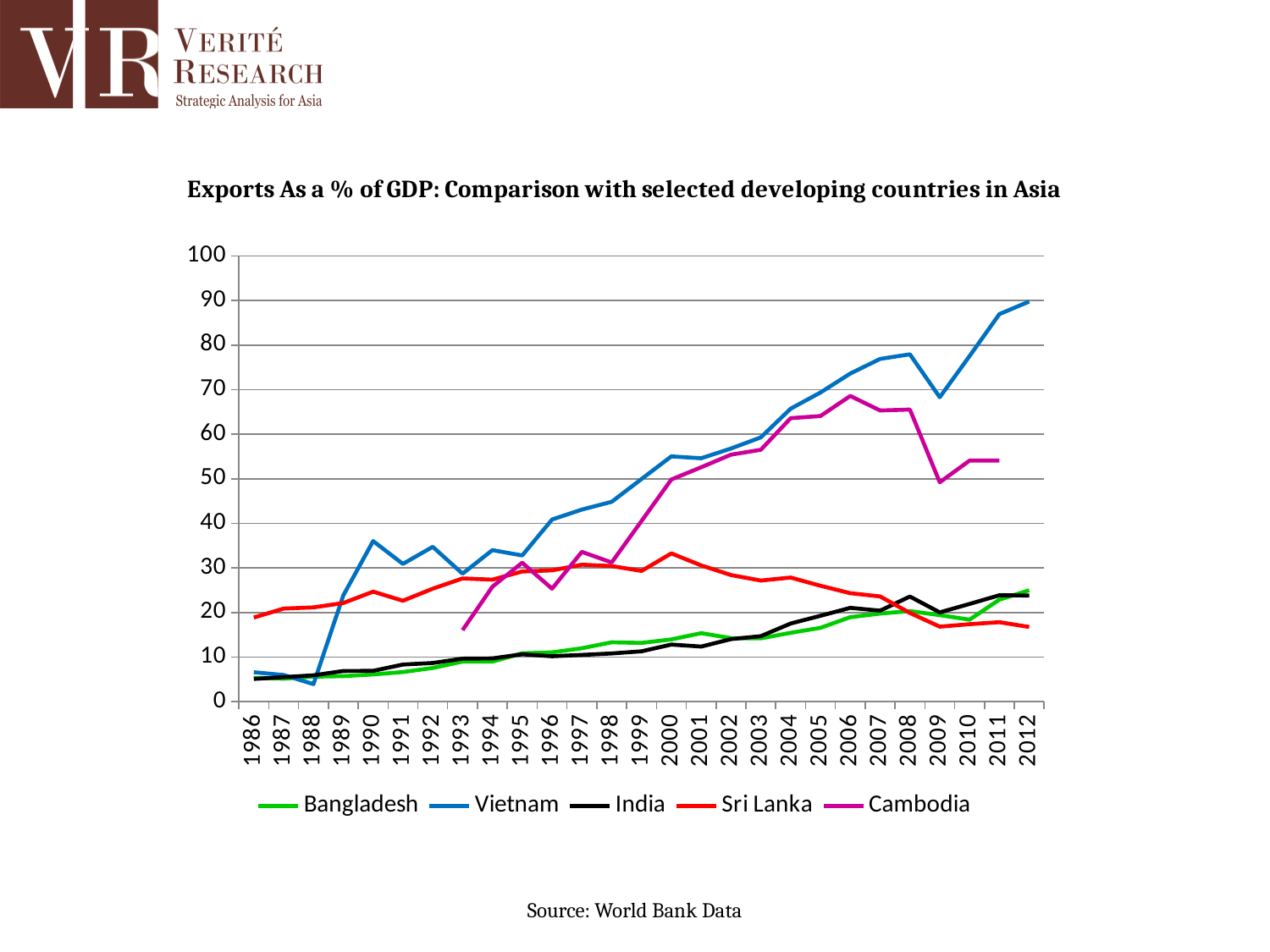
In 1986, which is larger: the value for Sri Lanka or the value for India? Sri Lanka Which country has the highest exports as a % of GDP in 2012? Vietnam Does the Sri Lanka line generally rise or fall from 2000 to 2012? fall Is the value for Sri Lanka in 2012 greater or less than 20? less Is the value for Cambodia in 2009 greater or less than 60? less How many years are plotted along the x axis? 27 What kind of chart is shown on the slide? line chart Does the Vietnam line generally rise or fall from 1986 to 2012? rise How many series does the legend list? 5 Which country has the lowest exports as a % of GDP in 2012? Sri Lanka What is the source of the data cited on the slide? World Bank Data Is the value for Vietnam in 2012 greater or less than 80? greater